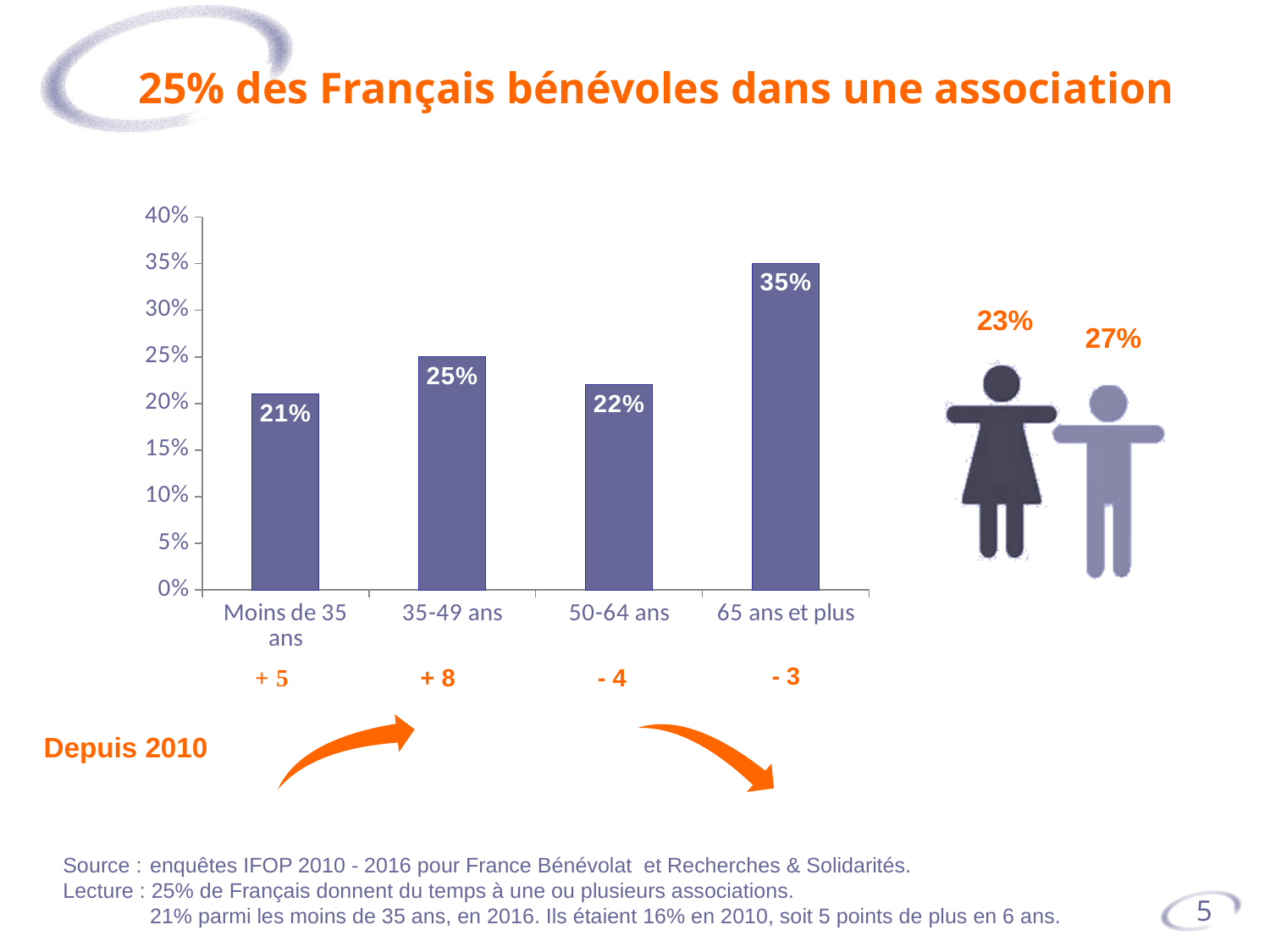
Which is larger, the value for '35-49 ans' or the value for '50-64 ans'? 35-49 ans What is the value for the '35-49 ans' category? 25% What is the value for the 'Moins de 35 ans' category? 21% Which age category has the highest value? 65 ans et plus What change since 2010 is shown below the '35-49 ans' bar? + 8 What is the value for the '65 ans et plus' category? 35% How many age categories are shown on the x axis of the chart? 4 What kind of chart is shown on the slide? bar chart What is the maximum value shown on the vertical axis of the chart? 40% Which age category has the lowest value? Moins de 35 ans Is the value for '65 ans et plus' greater or less than 30%? greater What is the difference between the values for '65 ans et plus' and '50-64 ans'? 13 percentage points